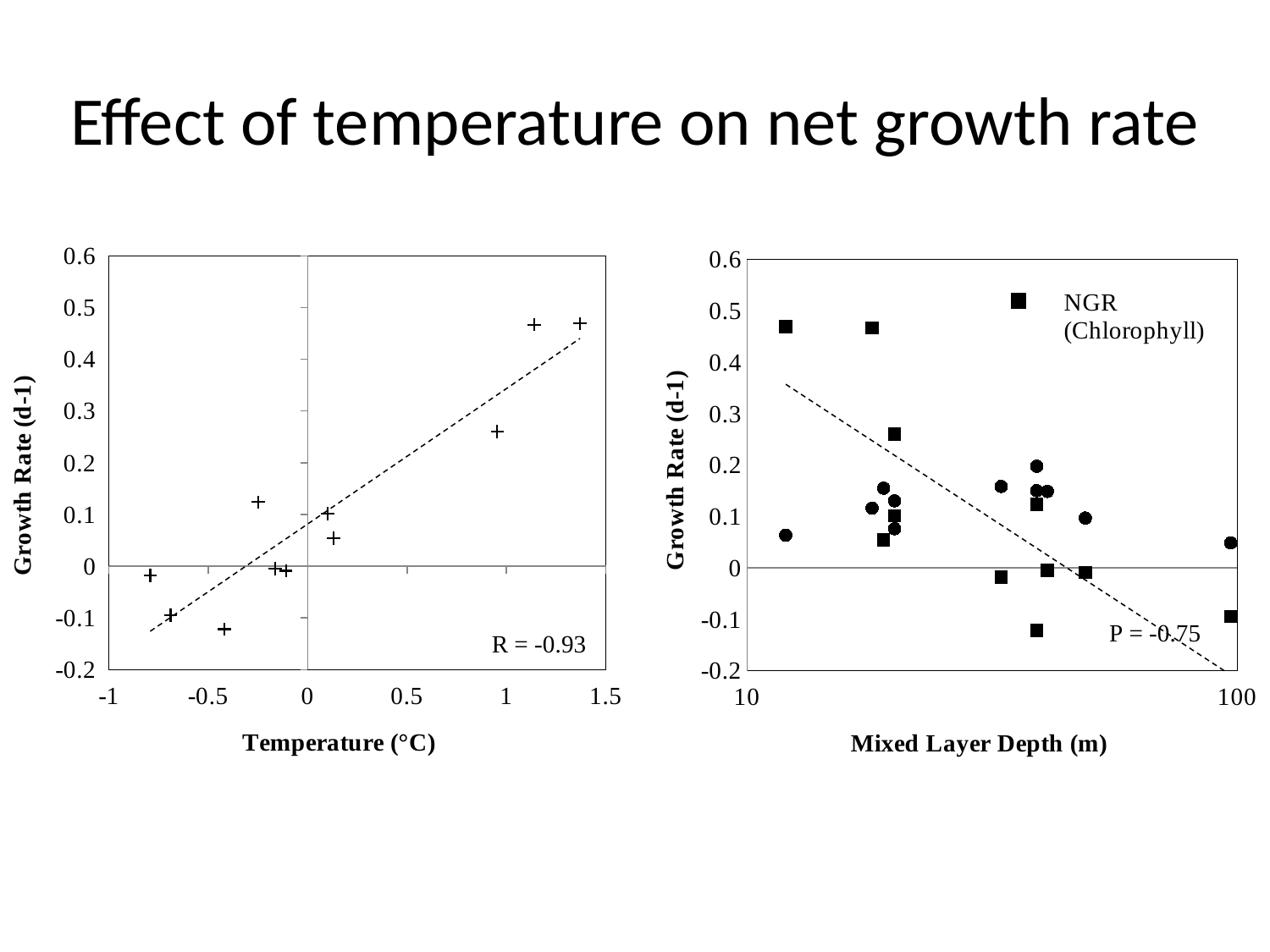
In the left chart, is the growth rate of the point at a temperature of about 1.15 °C greater or less than 0.4? greater In the left chart, does growth rate generally rise or fall as temperature increases along the x axis? rise In the right chart, does growth rate generally rise or fall as mixed layer depth increases along the x axis? fall What kind of chart is the right chart (Growth Rate vs Mixed Layer Depth)? scatter chart What correlation coefficient is printed on the left chart? R = -0.93 What kind of chart is the left chart (Growth Rate vs Temperature)? scatter chart In the left chart, is the growth rate of the point at a temperature of about -0.4 °C greater or less than 0? less In the right chart, is the growth rate of the square marker at a mixed layer depth of about 100 m greater or less than 0? less What is the legend entry shown on the right chart? NGR (Chlorophyll) How many data points are plotted in the left chart? 11 In the left chart, which point has the larger growth rate: the one at about 0.95 °C or the one at about -0.25 °C? the one at about 0.95 °C